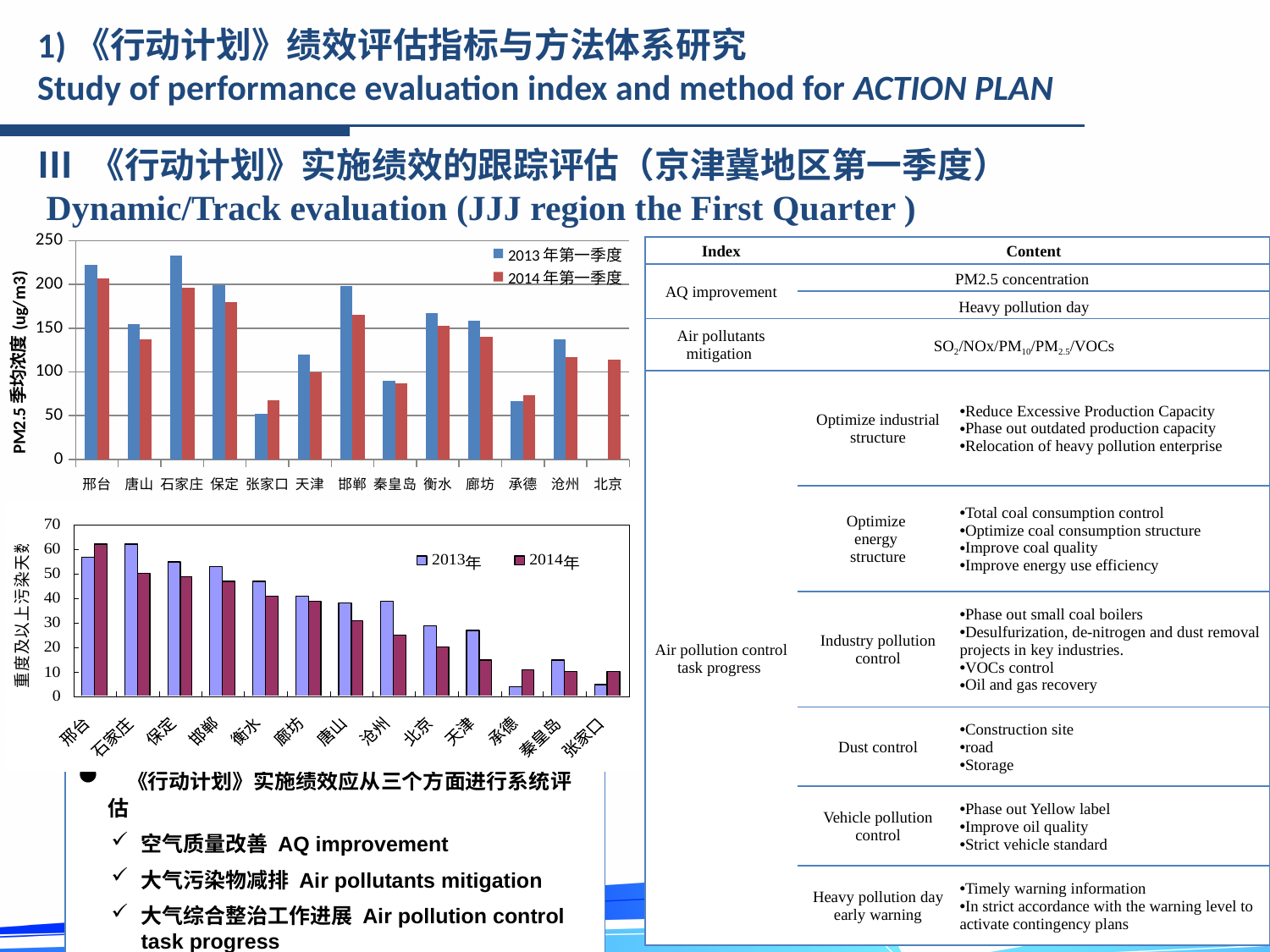
What is the y-axis label of the top chart? PM2.5 季均浓度 (ug/m3) In the top chart (PM2.5 季均浓度), which city has the lowest 2013年第一季度 value? 张家口 In the top chart (PM2.5 季均浓度), which city has the highest 2013年第一季度 value? 石家庄 How many cities are shown on the x axis of the top chart (PM2.5 季均浓度)? 13 In the top chart (PM2.5 季均浓度), which is larger for 唐山: the 2013年第一季度 value or the 2014年第一季度 value? 2013年第一季度 How many series does the legend of the bottom chart (重度及以上污染天数) list? 2 How many series does the legend of the top chart (PM2.5 季均浓度) list? 2 In the top chart (PM2.5 季均浓度), is the 2013年第一季度 value for 邢台 greater or less than 200? greater In the top chart (PM2.5 季均浓度), is the 2014年第一季度 value for 张家口 greater or less than 100? less What kind of chart is the top chart (PM2.5 季均浓度)? bar chart In the bottom chart (重度及以上污染天数), which is larger for 保定: the 2013年 value or the 2014年 value? 2013年 In the bottom chart (重度及以上污染天数), is the 2013年 value for 邢台 greater or less than 50? greater